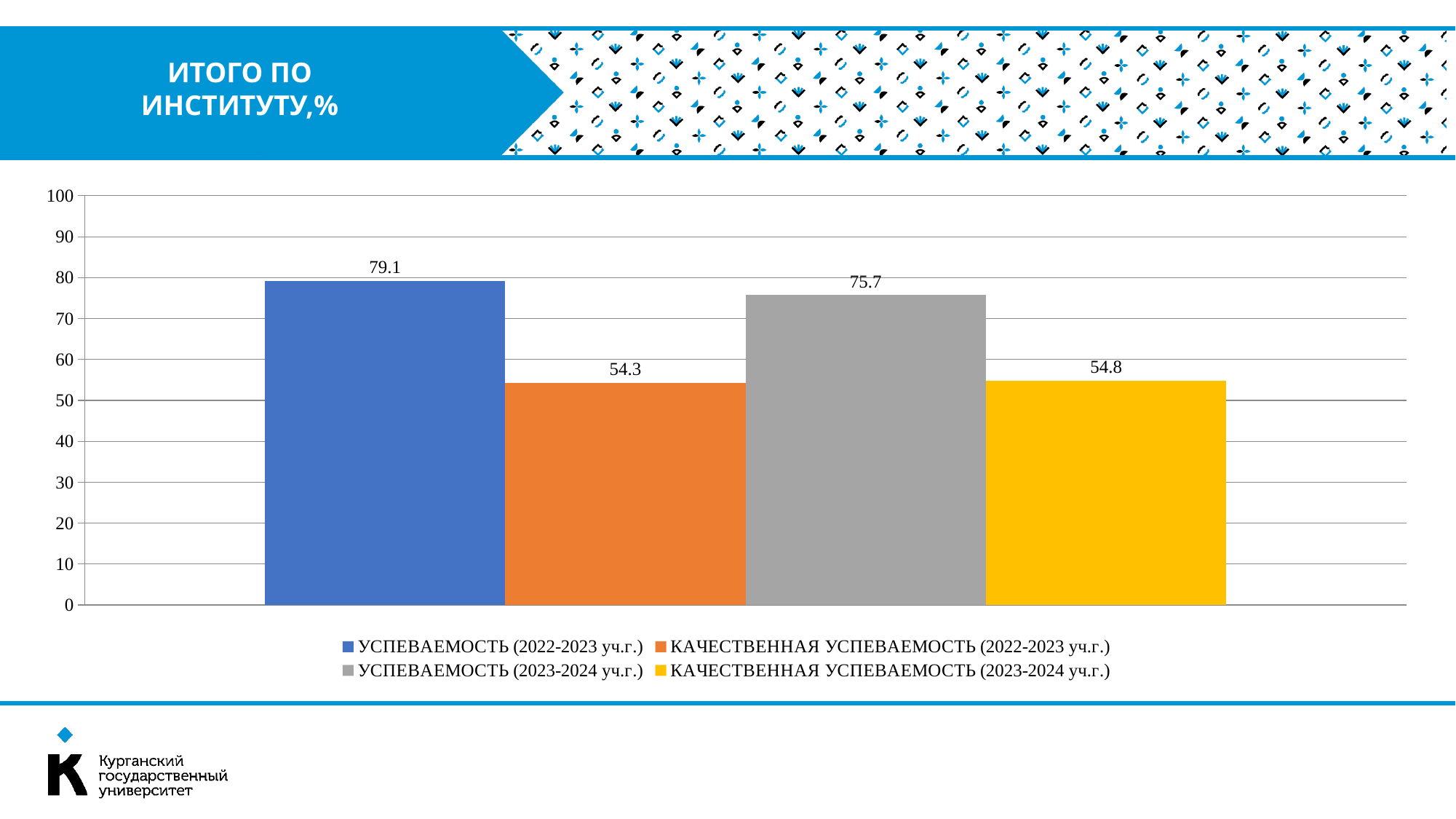
Which series has the lowest value? КАЧЕСТВЕННАЯ УСПЕВАЕМОСТЬ (2022-2023 уч.г.) What is the value for УСПЕВАЕМОСТЬ (2022-2023 уч.г.)? 79.1 Which series has the highest value? УСПЕВАЕМОСТЬ (2022-2023 уч.г.) What kind of chart is shown on the slide? bar chart How many series does the legend list? 4 Is the value for УСПЕВАЕМОСТЬ (2023-2024 уч.г.) greater or less than 70? greater What is the difference between УСПЕВАЕМОСТЬ (2023-2024 уч.г.) and КАЧЕСТВЕННАЯ УСПЕВАЕМОСТЬ (2023-2024 уч.г.)? 20.9 What is the value for КАЧЕСТВЕННАЯ УСПЕВАЕМОСТЬ (2023-2024 уч.г.)? 54.8 What is the value for УСПЕВАЕМОСТЬ (2023-2024 уч.г.)? 75.7 What is the value for КАЧЕСТВЕННАЯ УСПЕВАЕМОСТЬ (2022-2023 уч.г.)? 54.3 Which is larger: УСПЕВАЕМОСТЬ (2022-2023 уч.г.) or УСПЕВАЕМОСТЬ (2023-2024 уч.г.)? УСПЕВАЕМОСТЬ (2022-2023 уч.г.) What is the difference between УСПЕВАЕМОСТЬ (2022-2023 уч.г.) and УСПЕВАЕМОСТЬ (2023-2024 уч.г.)? 3.4